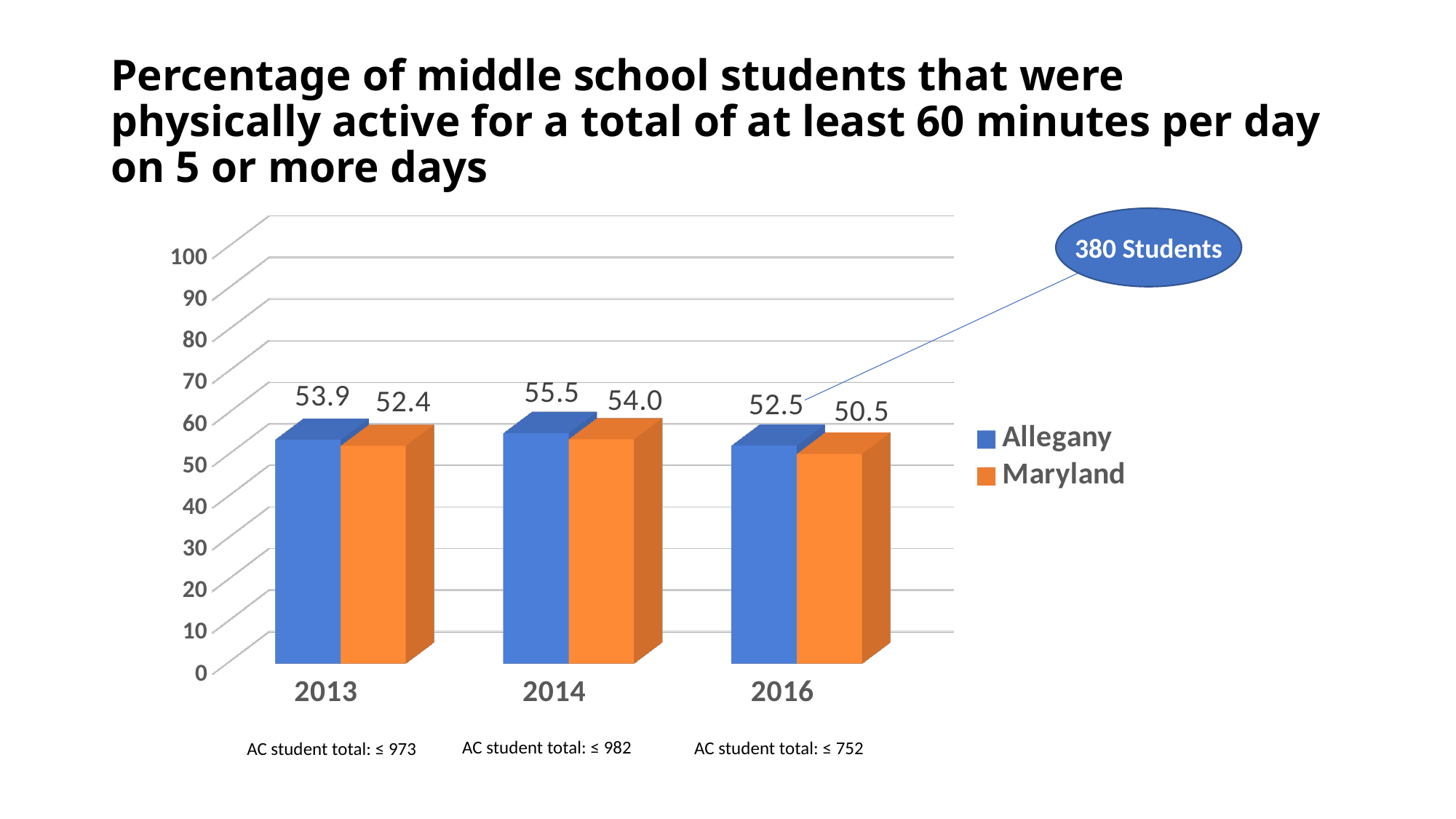
In which year is the Allegany value highest? 2014 What is the value for Maryland in 2014? 54.0 Which is larger in 2013, the Allegany value or the Maryland value? Allegany Does the Maryland value rise or fall from 2014 to 2016? Fall How many series does the legend list? 2 What does the callout bubble pointing to the 2016 Allegany bar say? 380 Students What is the value for Allegany in 2013? 53.9 What is the difference between the Allegany and Maryland values in 2016? 2.0 What kind of chart is shown on the slide? Bar chart How many years are shown on the x axis? 3 What is the value for Maryland in 2016? 50.5 In which year is the Maryland value lowest? 2016